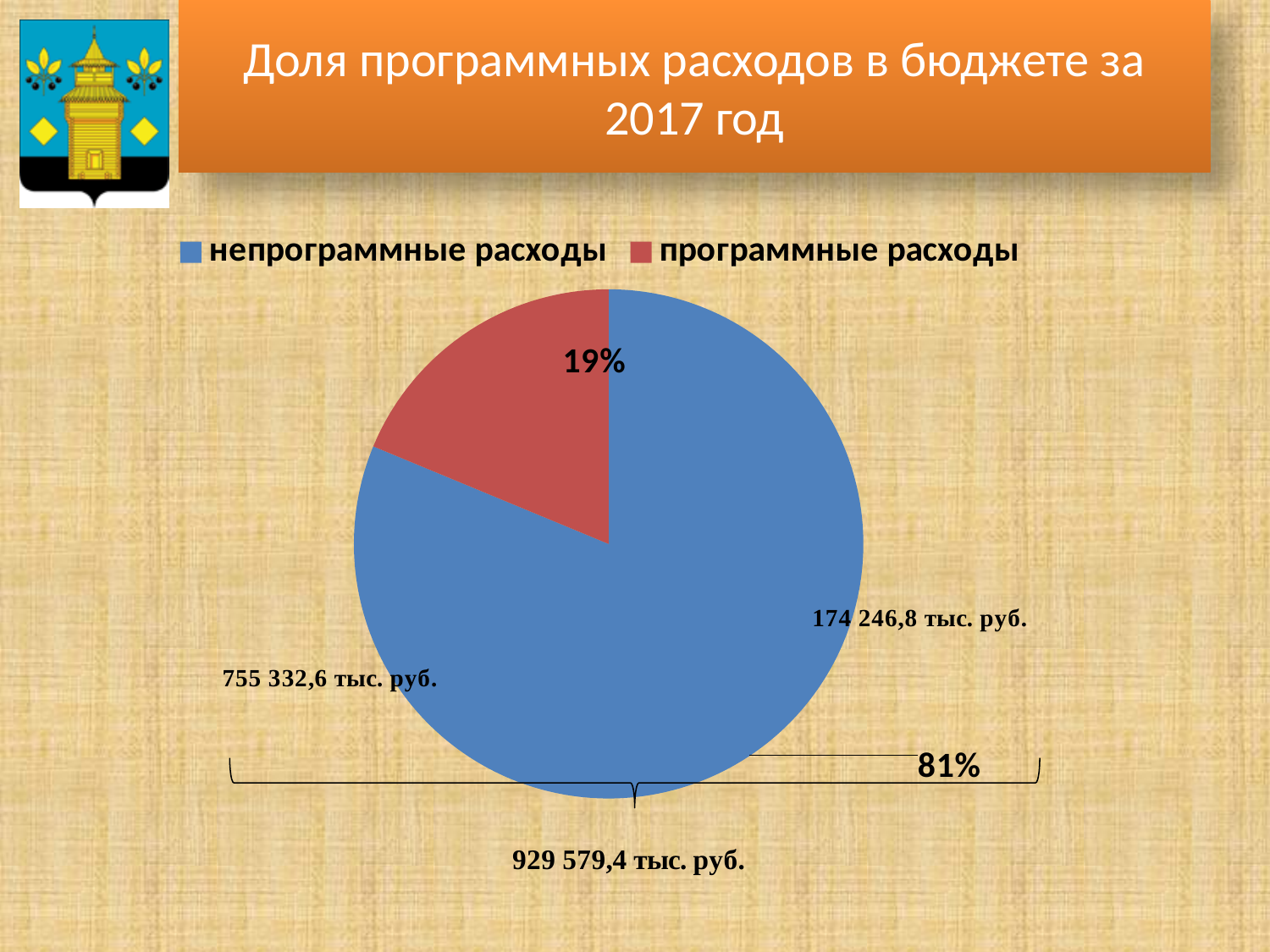
What total amount is shown below the pie chart? 929 579,4 тыс. руб. How many slices does the pie chart have? 2 What kind of chart is shown on the slide? pie chart Which slice is larger, непрограммные расходы or программные расходы? непрограммные расходы What share of the pie is программные расходы? 19% Which category has the largest slice of the pie? непрограммные расходы What is the title of the chart on the slide? Доля программных расходов в бюджете за 2017 год What is the difference in percentage points between the 81% slice and the 19% slice? 62 How many series does the legend list? 2 What colour is the slice for программные расходы? red Which category has the smallest slice of the pie? программные расходы What share of the pie is непрограммные расходы? 81%